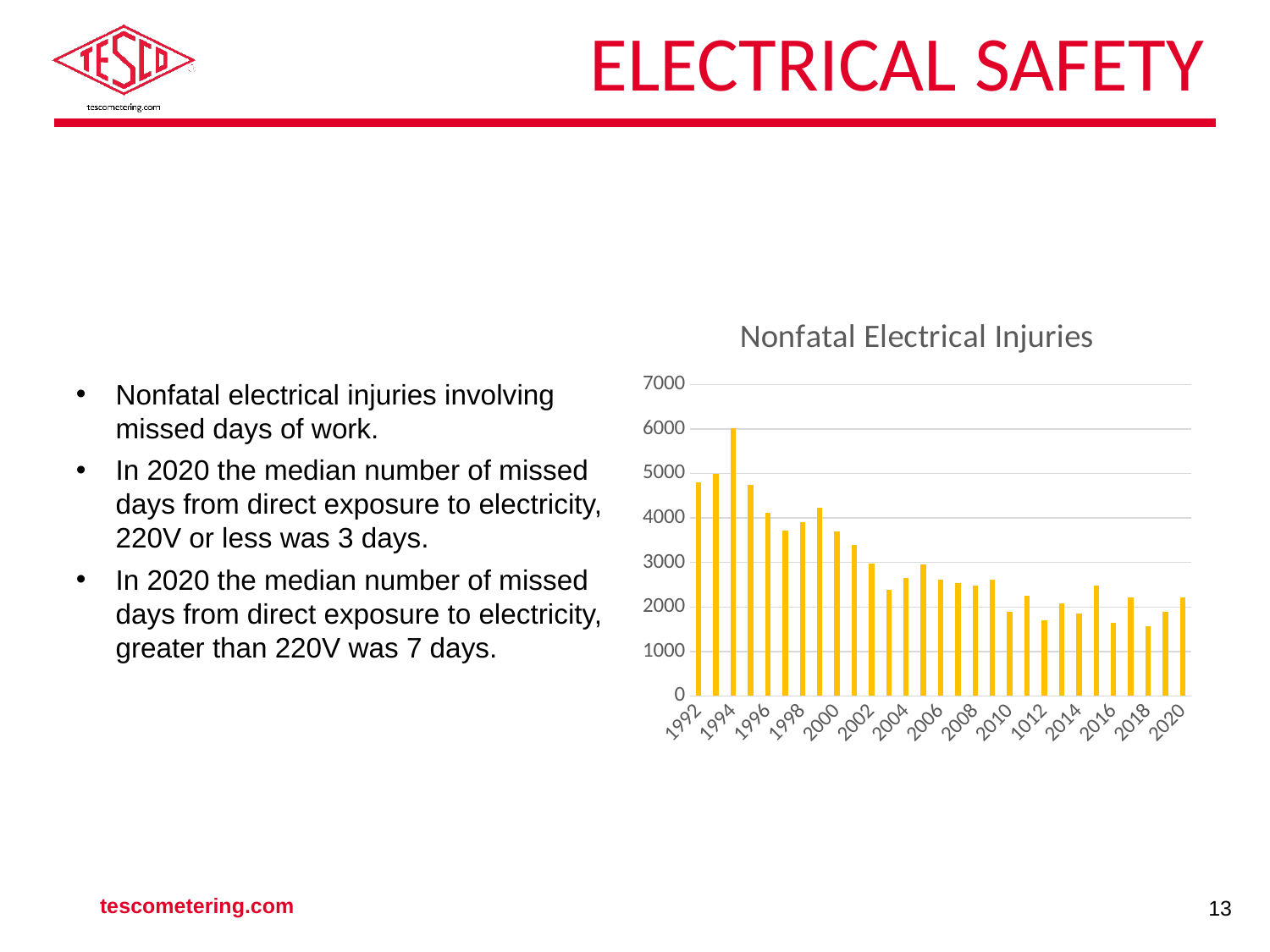
What is the highest value shown on the vertical axis? 7000 Is the value for 2020 greater or less than 2000? greater Is the value for 2018 greater or less than 2000? less What is the title of the chart? Nonfatal Electrical Injuries Which year has the highest number of nonfatal electrical injuries in the chart? 1994 Is the value for 2000 greater or less than 3000? greater Which year has the larger value, 1994 or 1996? 1994 Overall, do the values rise or fall from 1992 to 2020? Fall Which year has the larger value, 1992 or 2020? 1992 What type of chart is shown on the slide? Bar chart